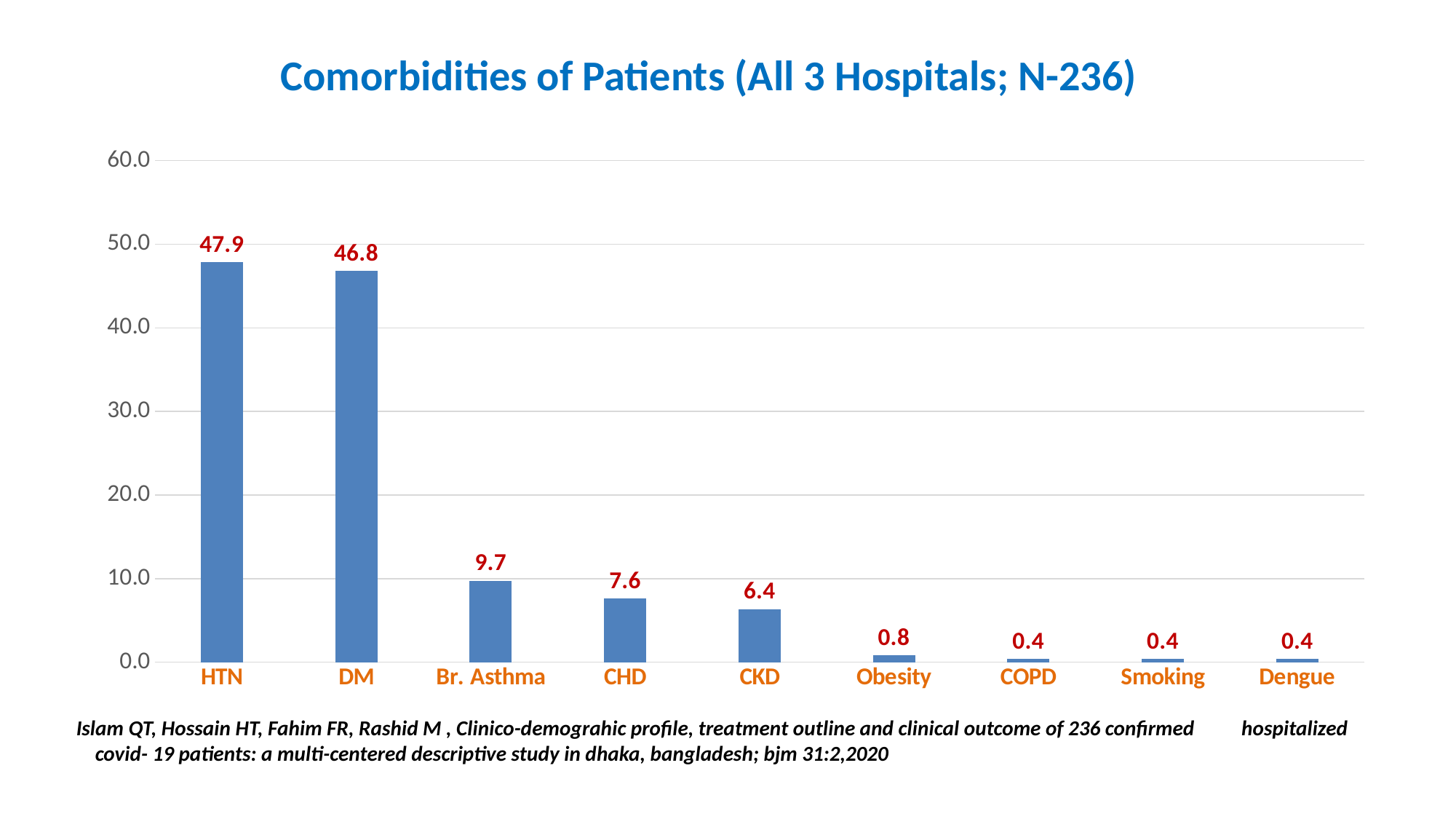
Is the value for DM greater or less than 40.0? greater Which comorbidity has the highest value? HTN What kind of chart is shown on the slide? bar chart What is the title of the chart? Comorbidities of Patients (All 3 Hospitals; N-236) What is the value for CKD? 6.4 What is the value for Obesity? 0.8 What is the value for HTN? 47.9 How many comorbidity categories are shown on the x axis? 9 What is the difference between the values for CHD and CKD? 1.2 Which is larger, the value for Br. Asthma or the value for CHD? Br. Asthma What is the difference between the values for HTN and DM? 1.1 What is the value for Br. Asthma? 9.7